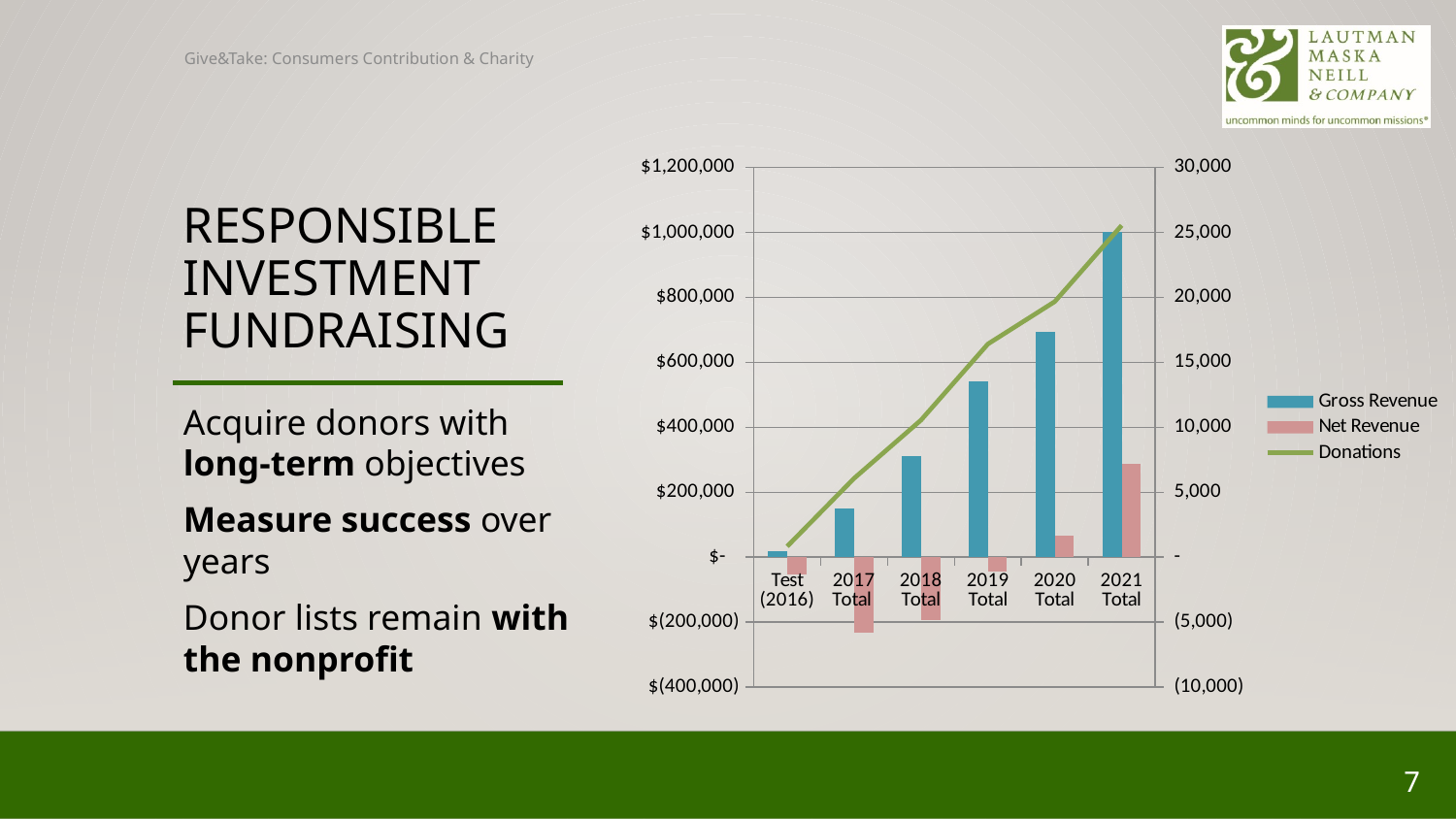
How many categories are shown along the x axis of the chart? 6 How many series does the chart's legend list? 3 Does the Donations line rise or fall from Test (2016) to 2021 Total? It rises Is the Gross Revenue for 2021 Total greater or less than $800,000? greater Which category has the highest Gross Revenue? 2021 Total Which series in the chart is drawn as a line rather than bars? Donations Is the Net Revenue for 2017 Total greater or less than $(200,000)? less Which is larger, the Gross Revenue for 2019 Total or for 2020 Total? 2020 Total What kind of chart is shown on the slide? A combined bar and line chart Which category has the lowest Gross Revenue? Test (2016) Which category has the lowest Net Revenue? 2017 Total Is the Gross Revenue for 2018 Total greater or less than $400,000? less